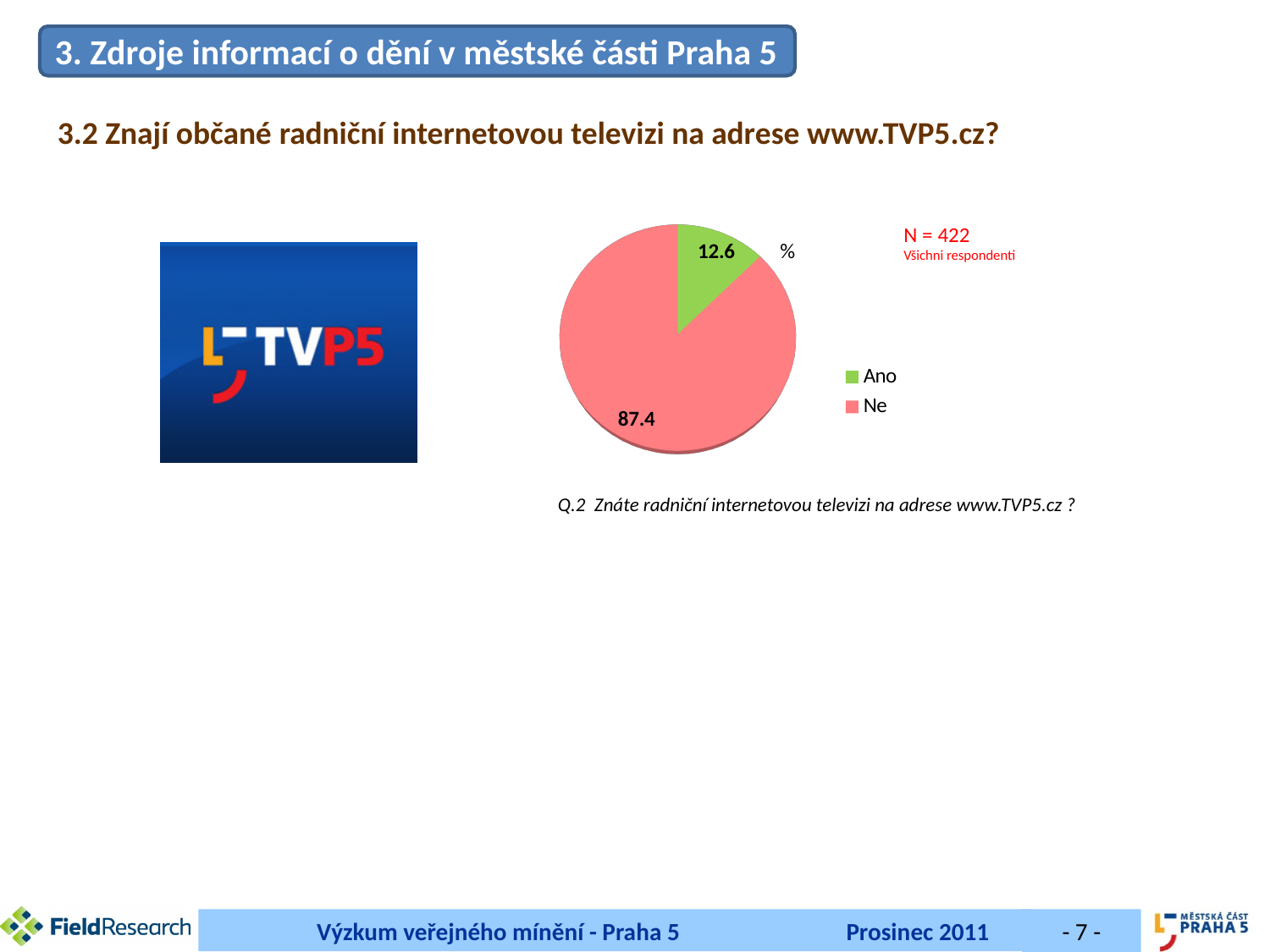
Which category has the largest slice in the pie chart? Ne Which is larger, the value for Ano or the value for Ne? Ne Which category has the smallest slice in the pie chart? Ano What kind of chart is shown on the slide? pie chart What is the value for Ne in the pie chart? 87.4 What colour is the Ne slice in the pie chart? red (pink) What is the number of respondents (N) stated next to the chart? 422 What is the value for Ano in the pie chart? 12.6 How many categories does the pie chart show? 2 What share of the pie does the Ano slice represent? 12.6% What is the difference between the values for Ne and Ano? 74.8 How many entries does the legend list? 2